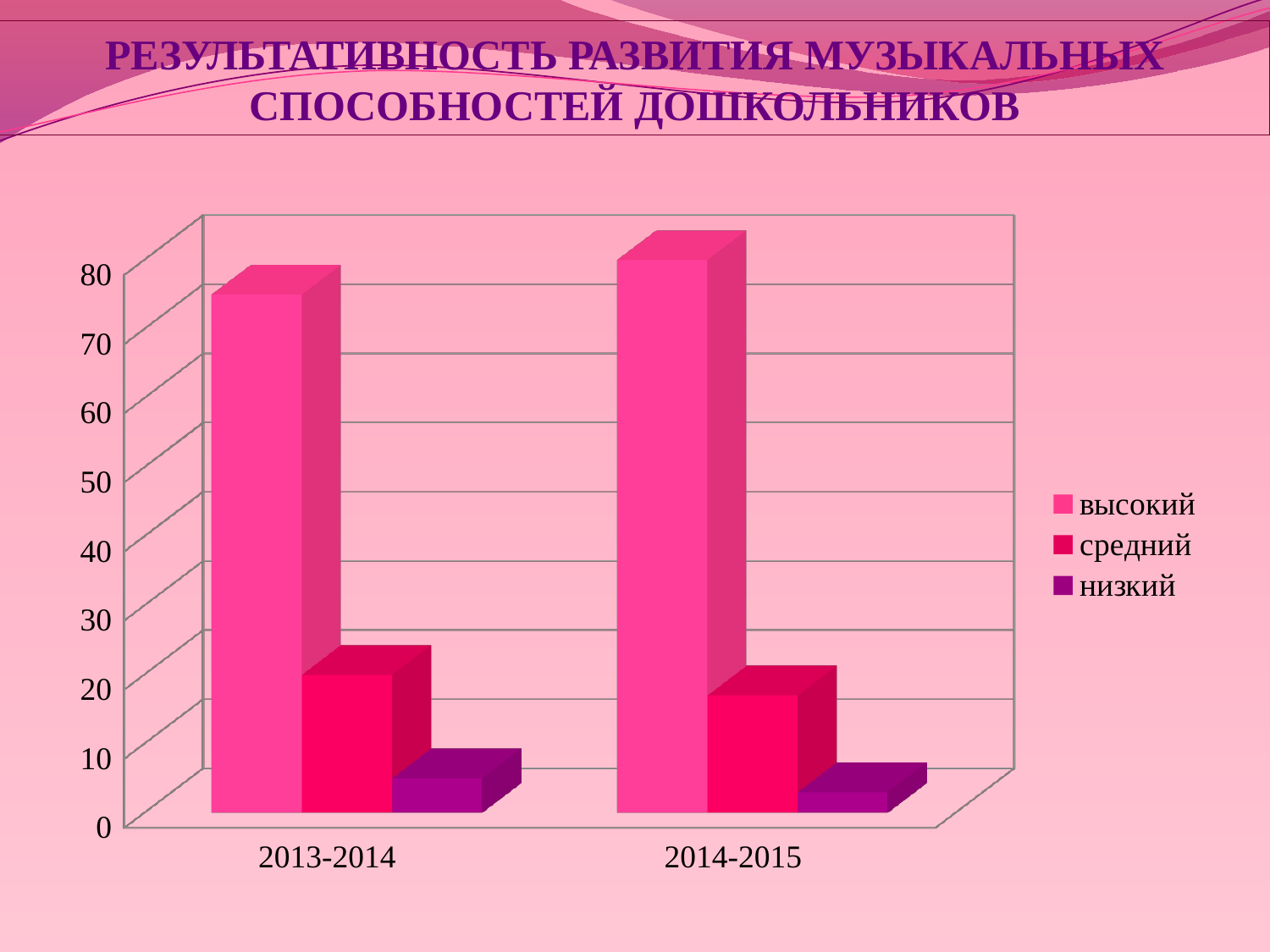
Does the value for высокий rise or fall from 2013-2014 to 2014-2015? rise Which series has the highest value in 2013-2014? высокий Is the value for средний in 2013-2014 greater or less than 30? less Which is larger, the value for высокий in 2013-2014 or in 2014-2015? 2014-2015 Is the value for низкий in 2014-2015 greater or less than 10? less How many series does the legend list? 3 How many categories are shown on the x axis? 2 Which series has the lowest value in 2014-2015? низкий Which is larger, the value for средний in 2013-2014 or in 2014-2015? 2013-2014 What kind of chart is shown on the slide? bar chart Is the value for высокий in 2013-2014 greater or less than 70? greater What are the three entries listed in the legend? высокий, средний, низкий